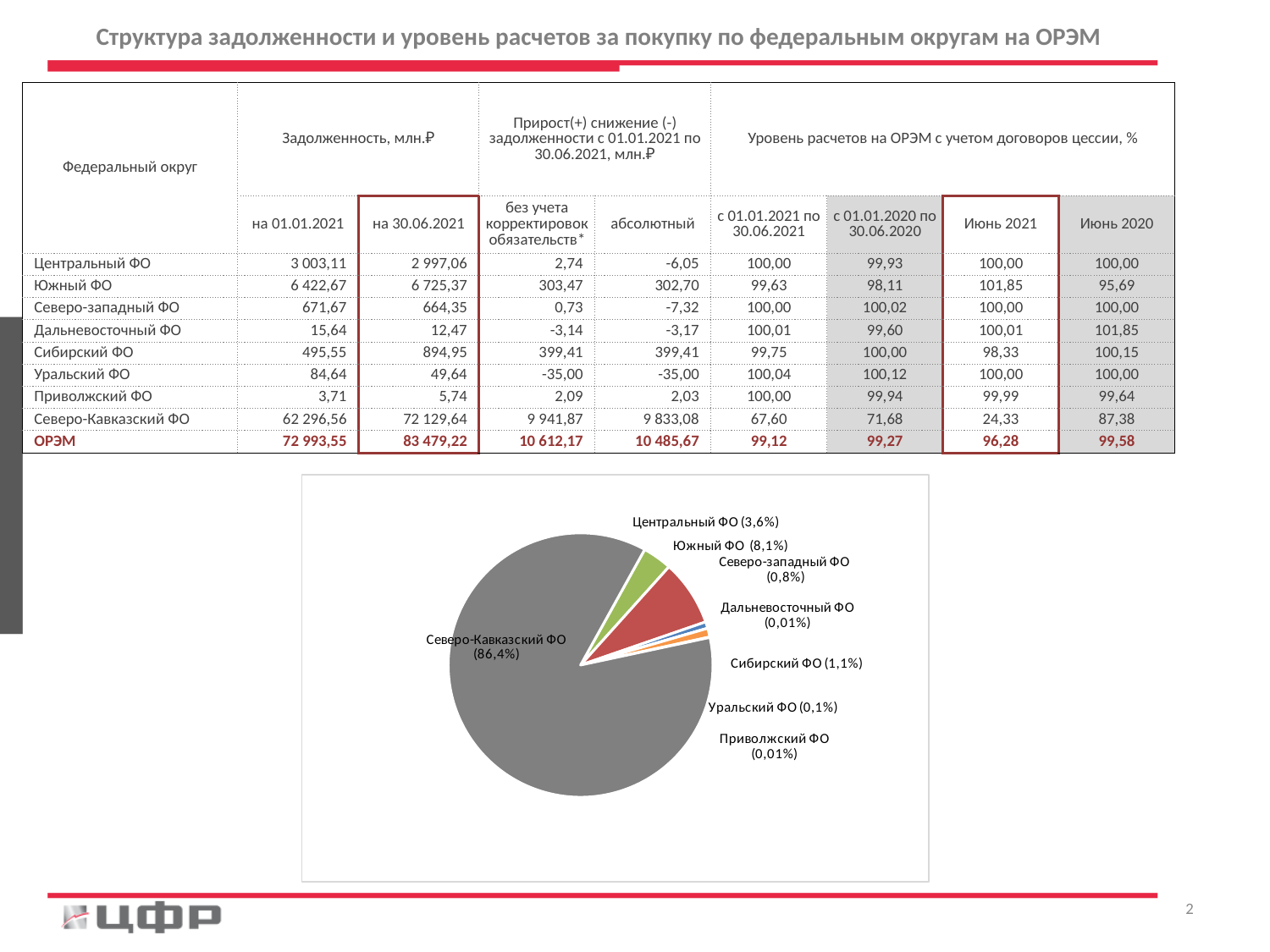
What is the difference in share between Южный ФО and Центральный ФО in the pie chart? 4,5% What kind of chart is shown on the slide? pie chart What share of the pie chart does Сибирский ФО have? 1,1% What share of the pie chart does Южный ФО have? 8,1% What share of the pie chart does Северо-Кавказский ФО have? 86,4% How many slices does the pie chart have? 8 Which slice is larger in the pie chart, Южный ФО or Центральный ФО? Южный ФО Which slice of the pie chart is the largest? Северо-Кавказский ФО Which two slices of the pie chart share the smallest value of 0,01%? Дальневосточный ФО and Приволжский ФО